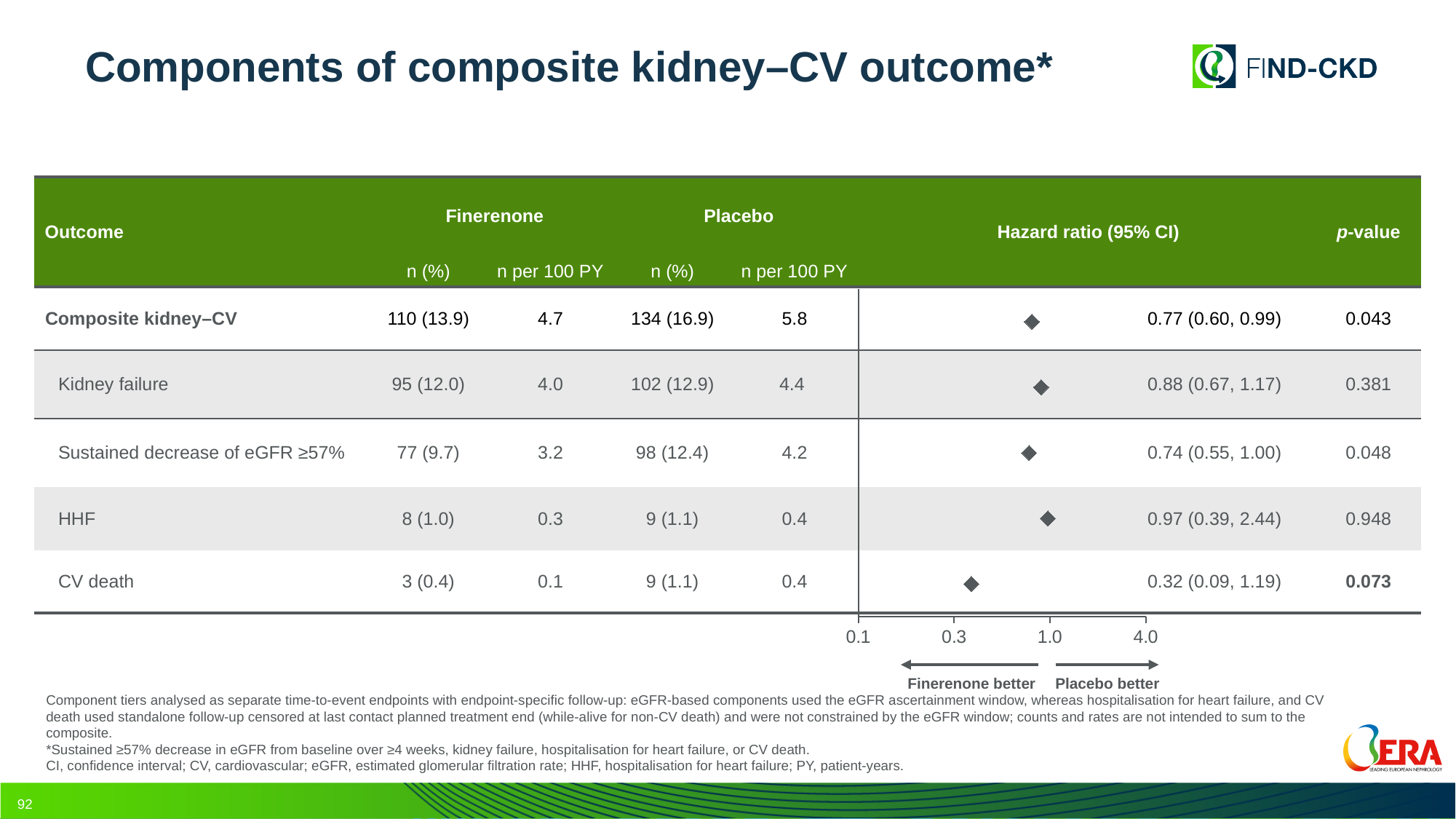
What label is shown under the left-pointing arrow below the forest plot? Finerenone better Is the hazard ratio for CV death greater or less than 1.0? less How many outcomes are plotted in the forest plot? 5 What tick values are shown on the hazard ratio axis? 0.1, 0.3, 1.0, 4.0 Which has the larger hazard ratio, Kidney failure or Sustained decrease of eGFR ≥57%? Kidney failure What is the p-value for HHF? 0.948 What kind of chart is shown alongside the table? Forest plot Which outcome has the lowest hazard ratio in the forest plot? CV death What is the difference between the hazard ratio for HHF and the hazard ratio for CV death? 0.65 What is the hazard ratio (95% CI) for the Composite kidney–CV outcome? 0.77 (0.60, 0.99) What is the hazard ratio (95% CI) for CV death? 0.32 (0.09, 1.19) Which outcome has the highest hazard ratio in the forest plot? HHF